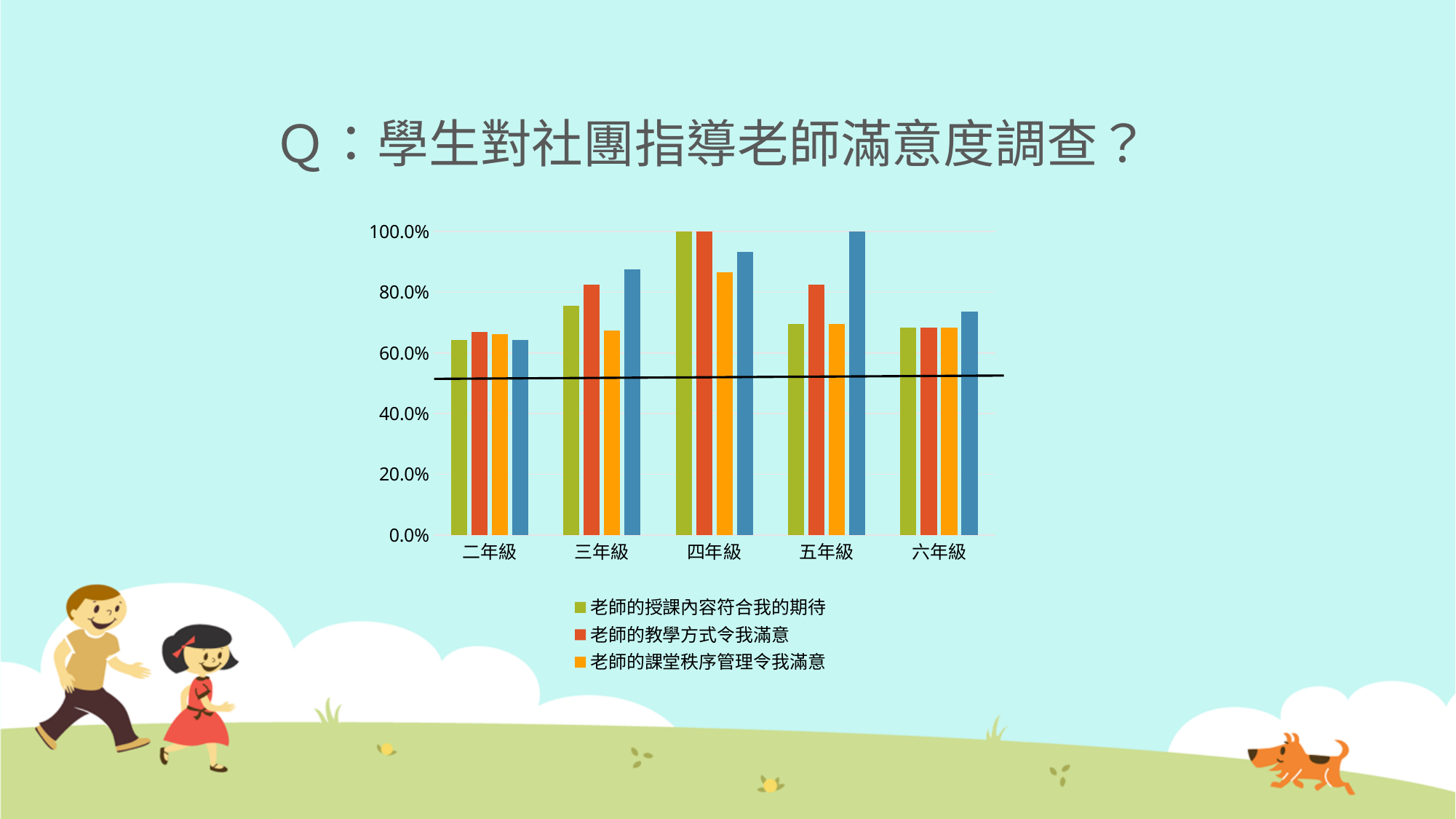
How many grade categories are shown on the x axis of the chart? 5 What is the value for 四年級 in the series 老師的授課內容符合我的期待? 100.0% For the series 老師的授課內容符合我的期待, which is larger: 三年級 or 六年級? 三年級 Is the value for 二年級 in the series 老師的授課內容符合我的期待 greater or less than 60.0%? greater How many series does the chart's legend list? 3 Is the value for 三年級 in the series 老師的課堂秩序管理令我滿意 greater or less than 80.0%? less Which grade has the highest value for 老師的授課內容符合我的期待? 四年級 What is the value for 四年級 in the series 老師的教學方式令我滿意? 100.0% Is the value for 六年級 in the series 老師的教學方式令我滿意 greater or less than 80.0%? less What kind of chart is shown on the slide? bar chart What is the title of the slide containing the chart? Q：學生對社團指導老師滿意度調查？ Which grade has the highest value for 老師的教學方式令我滿意? 四年級